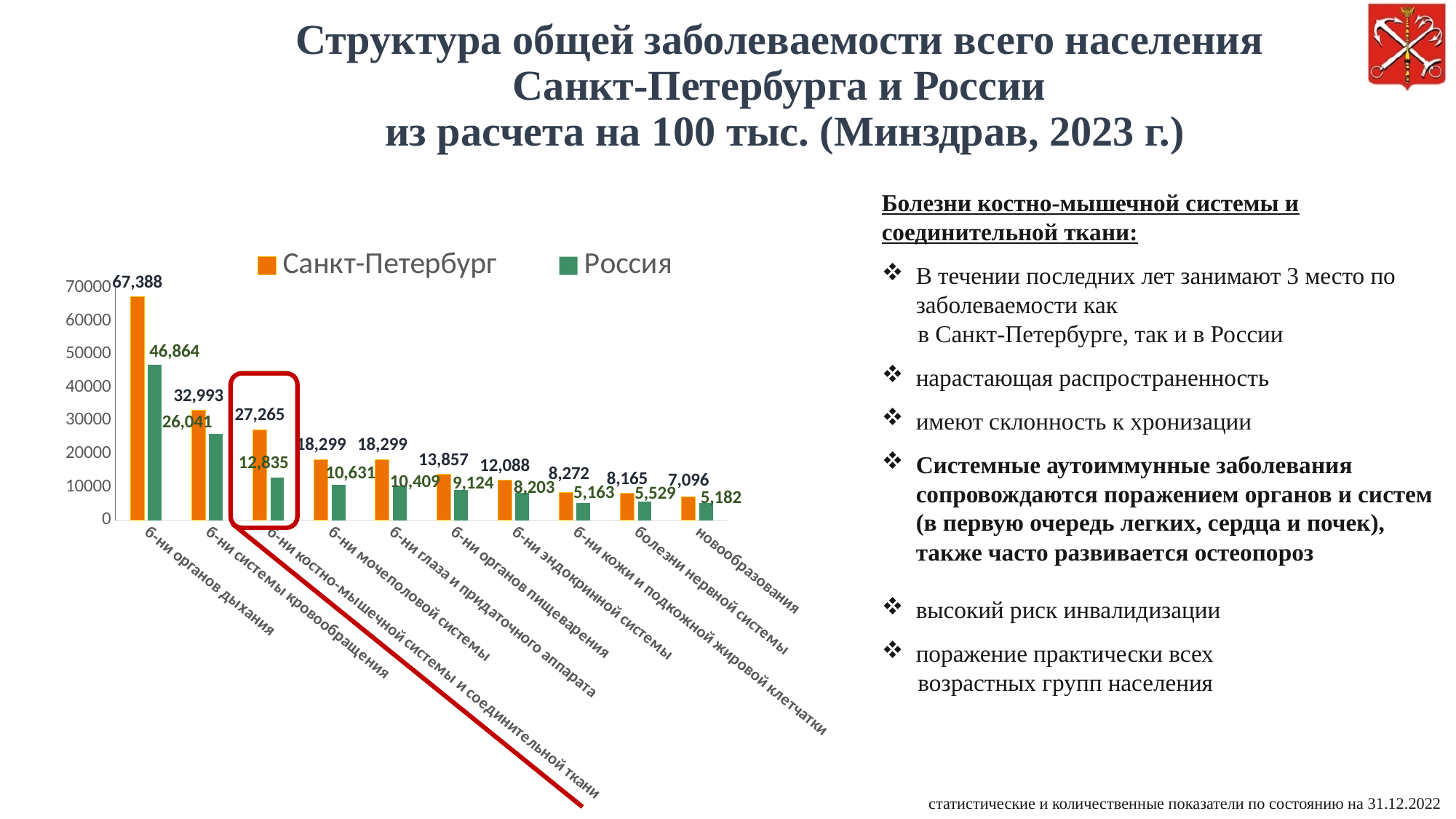
What is the difference between the Санкт-Петербург and Россия values for б-ни органов дыхания? 20,524 Which category has the lowest value for Санкт-Петербург? новообразования How many disease categories are plotted on the x axis? 10 What is the value for Санкт-Петербург for б-ни органов дыхания? 67,388 What is the value for Россия for б-ни костно-мышечной системы и соединительной ткани? 12,835 What is the value for Россия for болезни нервной системы? 5,529 What is the difference between the Санкт-Петербург and Россия values for б-ни костно-мышечной системы и соединительной ткани? 14,430 Do the Санкт-Петербург values rise or fall moving left to right along the x axis? fall What kind of chart is shown on the slide? bar chart Which category has the highest value for Санкт-Петербург? б-ни органов дыхания Which is larger: the Санкт-Петербург value for б-ни системы кровообращения or the Россия value for б-ни органов дыхания? the Россия value for б-ни органов дыхания How many series does the legend list? 2